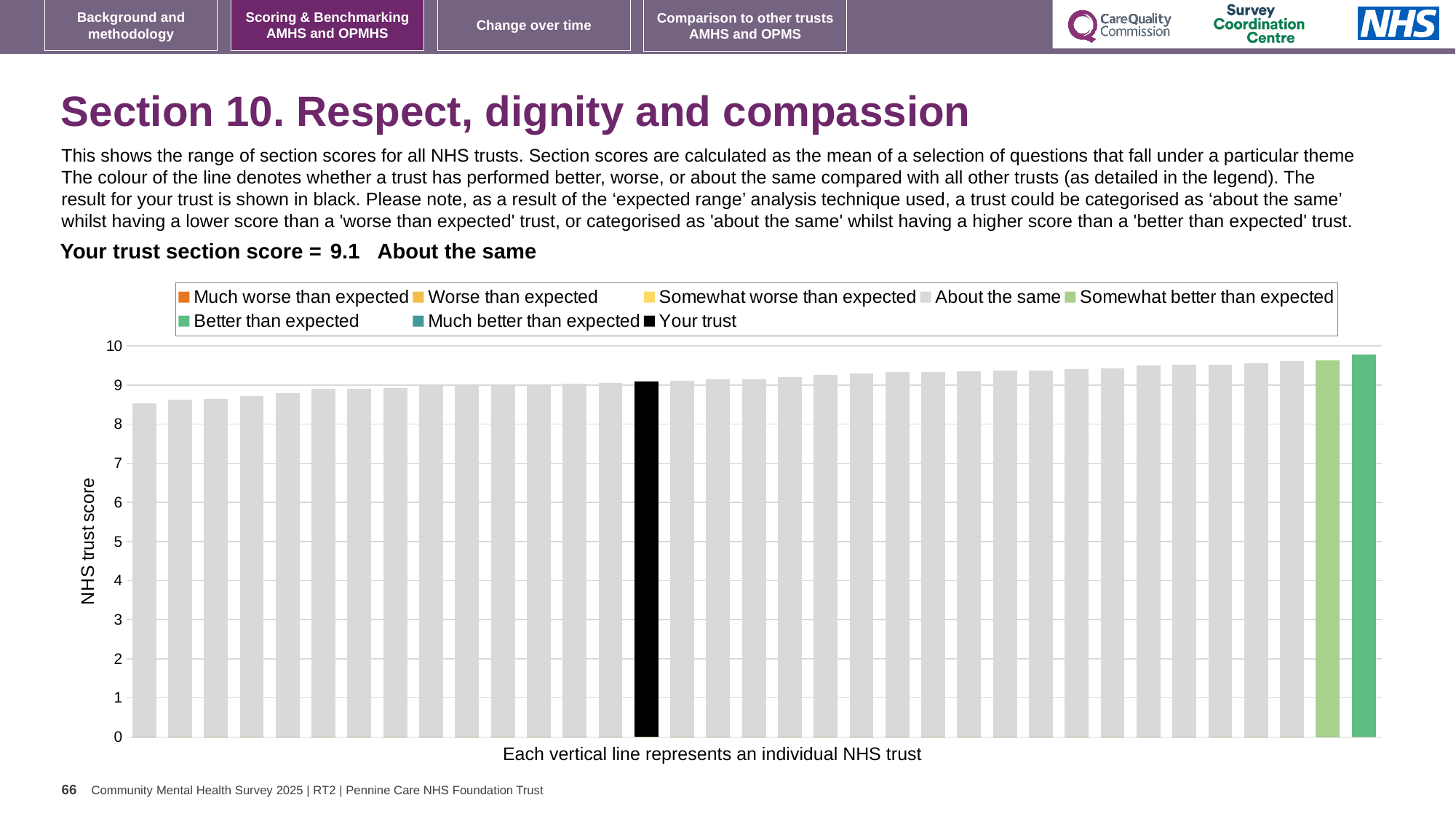
What is the label below the horizontal axis of the chart? Each vertical line represents an individual NHS trust How many entries does the chart legend list? 8 What kind of chart is shown on the slide? bar chart What is the section score for your trust shown on the slide? 9.1 How many bars in the chart are coloured green (somewhat better or better than expected)? 2 Which is larger: the black bar for your trust or the leftmost bar? the black bar for your trust Do the bar values rise or fall from left to right across the chart? rise Is the value of the leftmost bar greater or less than 9? less Is the value of the rightmost bar greater or less than 9? greater How is your trust's section score categorised compared with other trusts? About the same Is the value of the black bar (your trust) greater or less than 9? greater What is the label on the vertical axis of the chart? NHS trust score